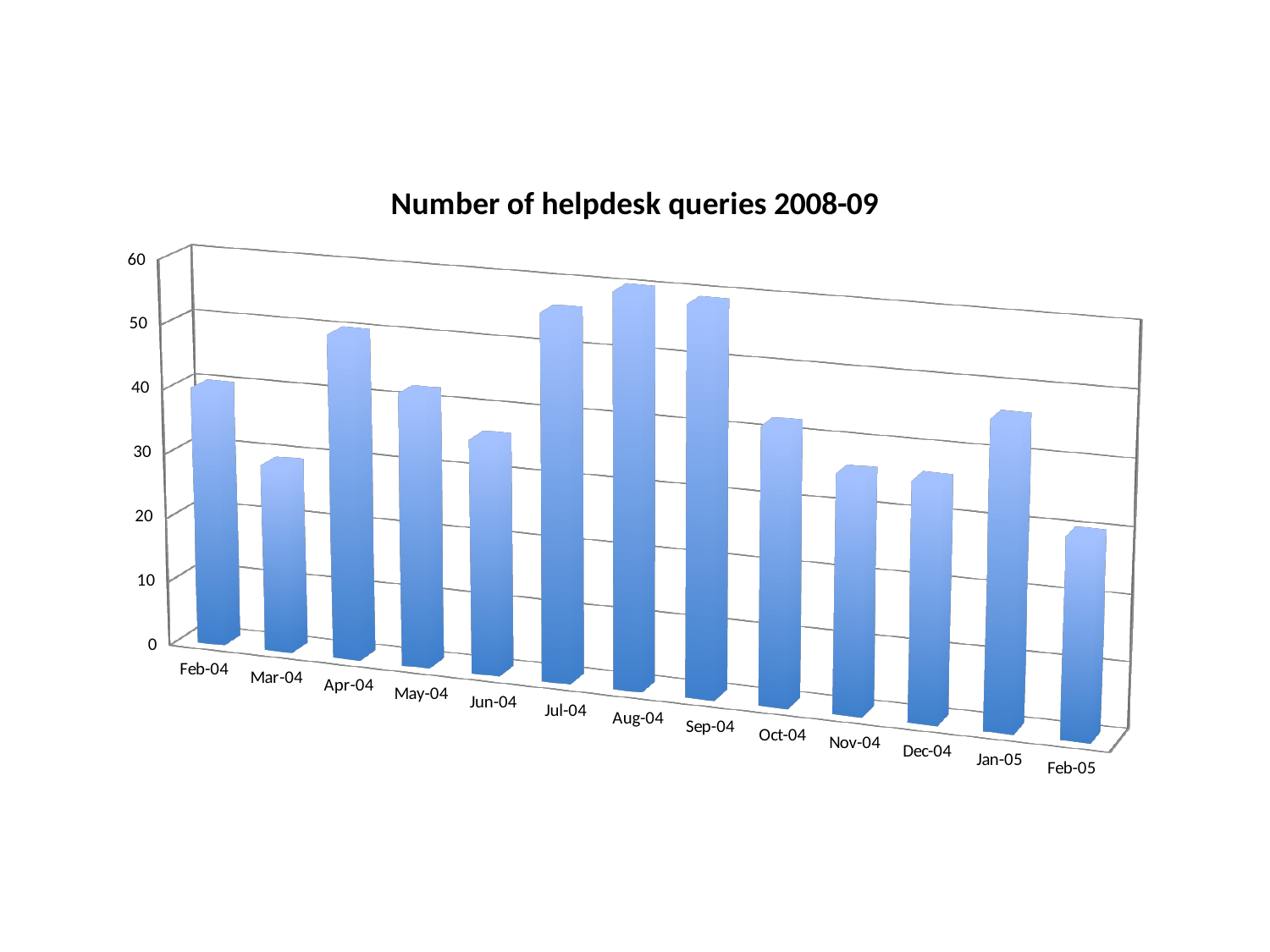
Which month has more helpdesk queries, Mar-04 or Apr-04? Apr-04 What type of chart is shown on the slide? Bar chart Is the value for Apr-04 greater or less than 40? greater Which month has more helpdesk queries, Dec-04 or Jan-05? Jan-05 Which month has the highest number of helpdesk queries? Aug-04 What is the title of the chart? Number of helpdesk queries 2008-09 Is the value for Aug-04 greater or less than 50? greater How many months (categories) are plotted on the chart? 13 Do the values rise or fall from Sep-04 to Dec-04? fall